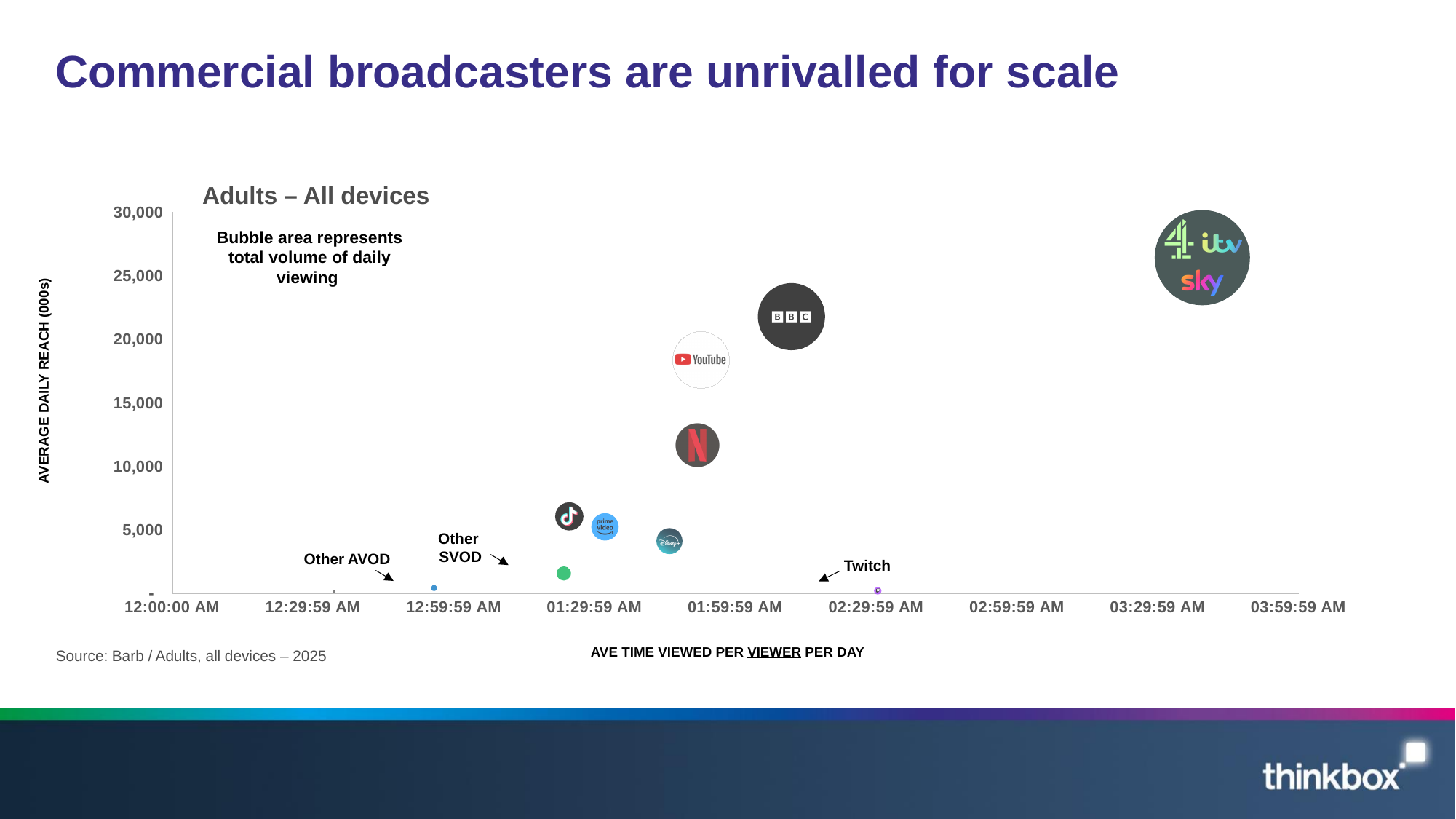
Is the average daily reach for Netflix greater or less than 15,000? less Which has the higher average daily reach, Netflix or YouTube? YouTube How many bubbles are plotted on the chart? 11 Which labelled bubble has the lowest average daily reach? Twitch What kind of chart is shown on the slide? Bubble chart Is the average daily reach for TikTok greater or less than 10,000? less Which has the higher average daily reach, BBC or YouTube? BBC Is the average daily reach for BBC greater or less than 20,000? greater Which bubble has the highest average daily reach? Channel 4 / ITV / Sky (commercial broadcasters) According to the chart note, what does the bubble area represent? Total volume of daily viewing